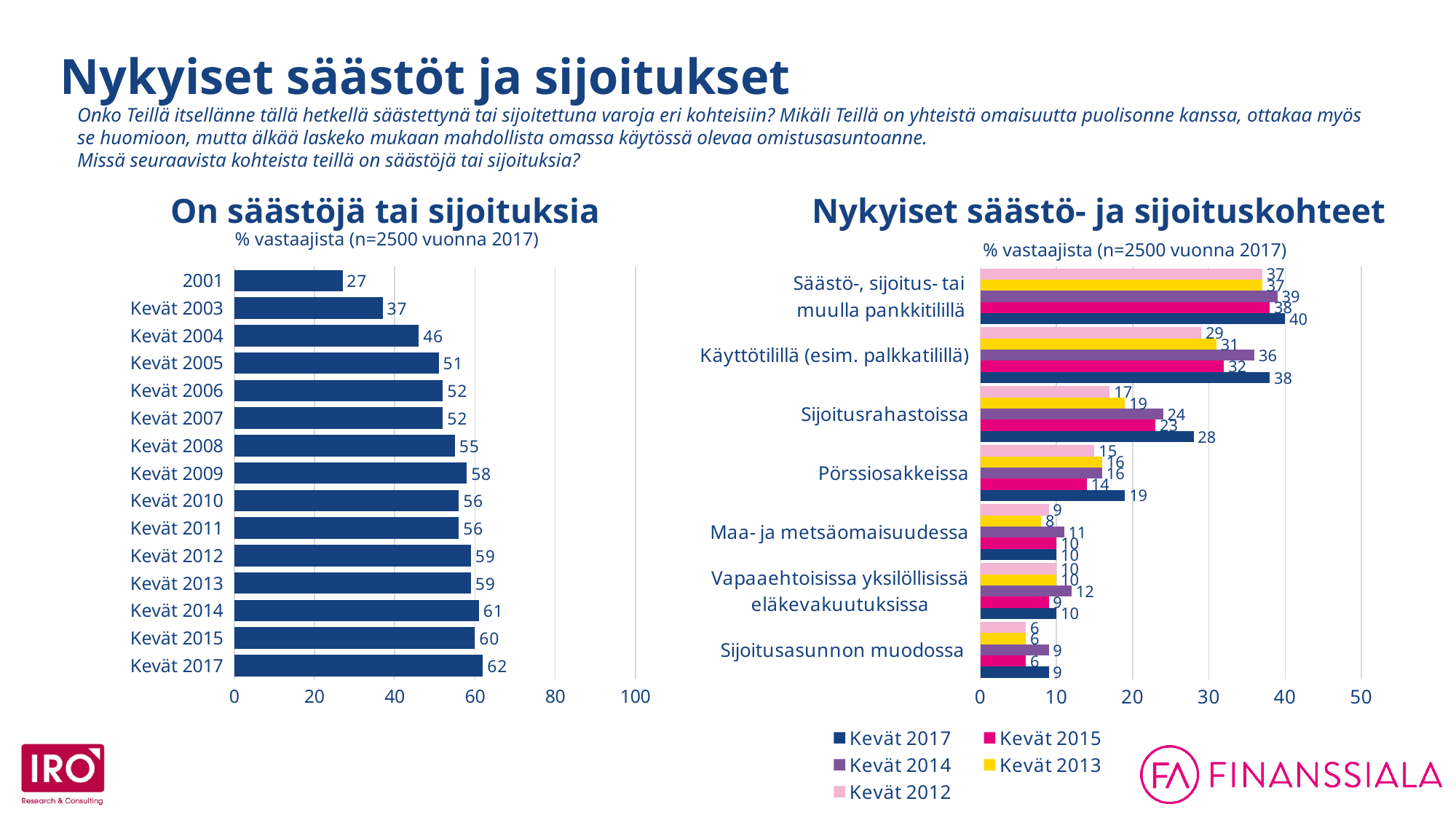
How many categories are shown in the chart 'On säästöjä tai sijoituksia'? 15 How many series does the legend of the chart 'Nykyiset säästö- ja sijoituskohteet' list? 5 In the chart 'On säästöjä tai sijoituksia', which category has the lowest value? 2001 In the chart 'Nykyiset säästö- ja sijoituskohteet', what is the Kevät 2017 value for Sijoitusrahastoissa? 28 What kind of chart is 'On säästöjä tai sijoituksia'? Bar chart In the chart 'Nykyiset säästö- ja sijoituskohteet', which category has the highest Kevät 2017 value? Säästö-, sijoitus- tai muulla pankkitilillä In the chart 'On säästöjä tai sijoituksia', what is the value for Kevät 2017? 62 In the chart 'Nykyiset säästö- ja sijoituskohteet', which is larger for Pörssiosakkeissa: the Kevät 2017 value or the Kevät 2015 value? Kevät 2017 In the chart 'Nykyiset säästö- ja sijoituskohteet', what is the Kevät 2014 value for Käyttötilillä (esim. palkkatilillä)? 36 In the chart 'On säästöjä tai sijoituksia', is the value for Kevät 2004 greater or less than 40? greater In the chart 'On säästöjä tai sijoituksia', what is the difference between the values for Kevät 2017 and 2001? 35 In the chart 'Nykyiset säästö- ja sijoituskohteet', what is the difference between the Kevät 2017 and Kevät 2012 values for Käyttötilillä (esim. palkkatilillä)? 9